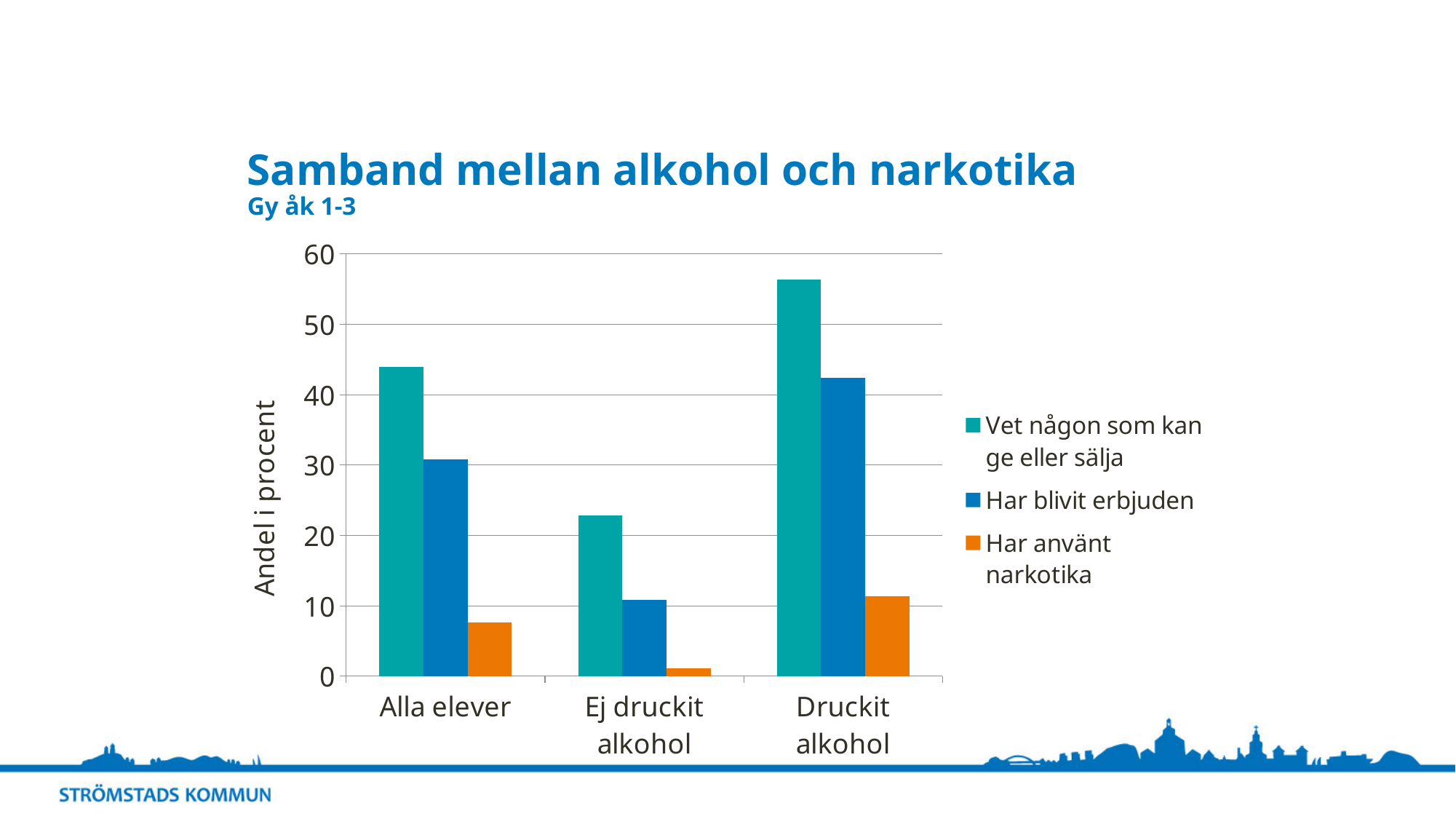
Which category has the highest value for "Vet någon som kan ge eller sälja"? Druckit alkohol Which is larger: "Har använt narkotika" for "Alla elever" or "Har använt narkotika" for "Ej druckit alkohol"? Alla elever What kind of chart is shown on the slide? bar chart Is the value for "Vet någon som kan ge eller sälja" in the "Druckit alkohol" category greater or less than 50? greater Is the value for "Har blivit erbjuden" in the "Ej druckit alkohol" category greater or less than 20? less What is the title of the chart on the slide? Samband mellan alkohol och narkotika How many categories are shown on the x axis? 3 What is the label of the y axis? Andel i procent Which is larger: "Har blivit erbjuden" for "Alla elever" or "Har blivit erbjuden" for "Druckit alkohol"? Druckit alkohol Is the value for "Vet någon som kan ge eller sälja" in the "Alla elever" category greater or less than 40? greater How many series does the legend list? 3 Which category has the lowest value for "Har använt narkotika"? Ej druckit alkohol